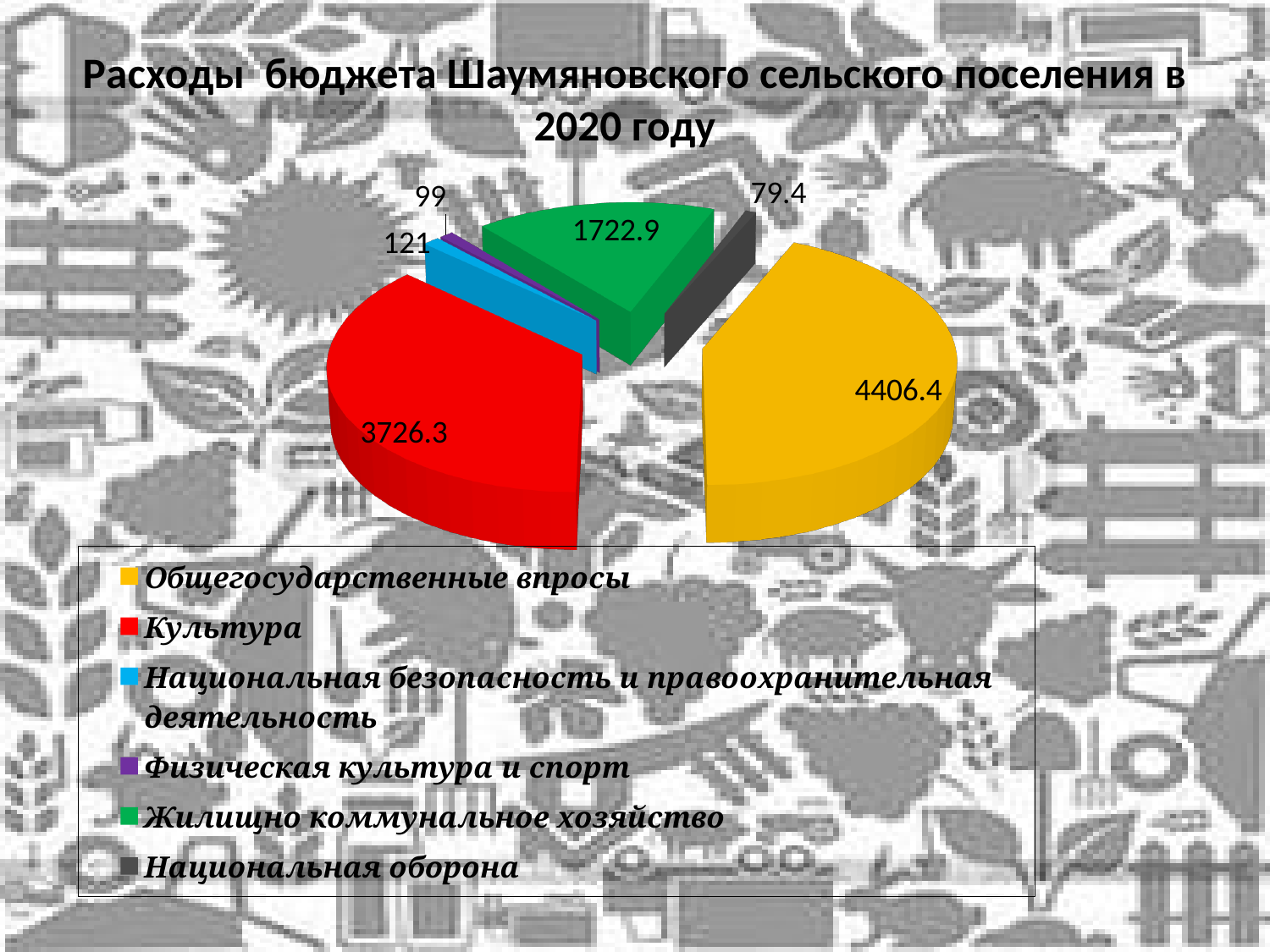
What is the value for Физическая культура и спорт? 99 How many categories does the legend list? 6 Which category has the largest slice of the pie? Общегосударственные впросы What is the value for Культура? 3726.3 What is the value for Жилищно коммунальное хозяйство? 1722.9 What is the value for Общегосударственные впросы? 4406.4 Which is larger: Национальная безопасность и правоохранительная деятельность or Физическая культура и спорт? Национальная безопасность и правоохранительная деятельность What is the title of the chart? Расходы бюджета Шаумяновского сельского поселения в 2020 году What is the value for Национальная оборона? 79.4 What kind of chart is shown on the slide? Pie chart Which category has the smallest slice of the pie? Национальная оборона What is the difference between the values for Общегосударственные впросы and Культура? 680.1